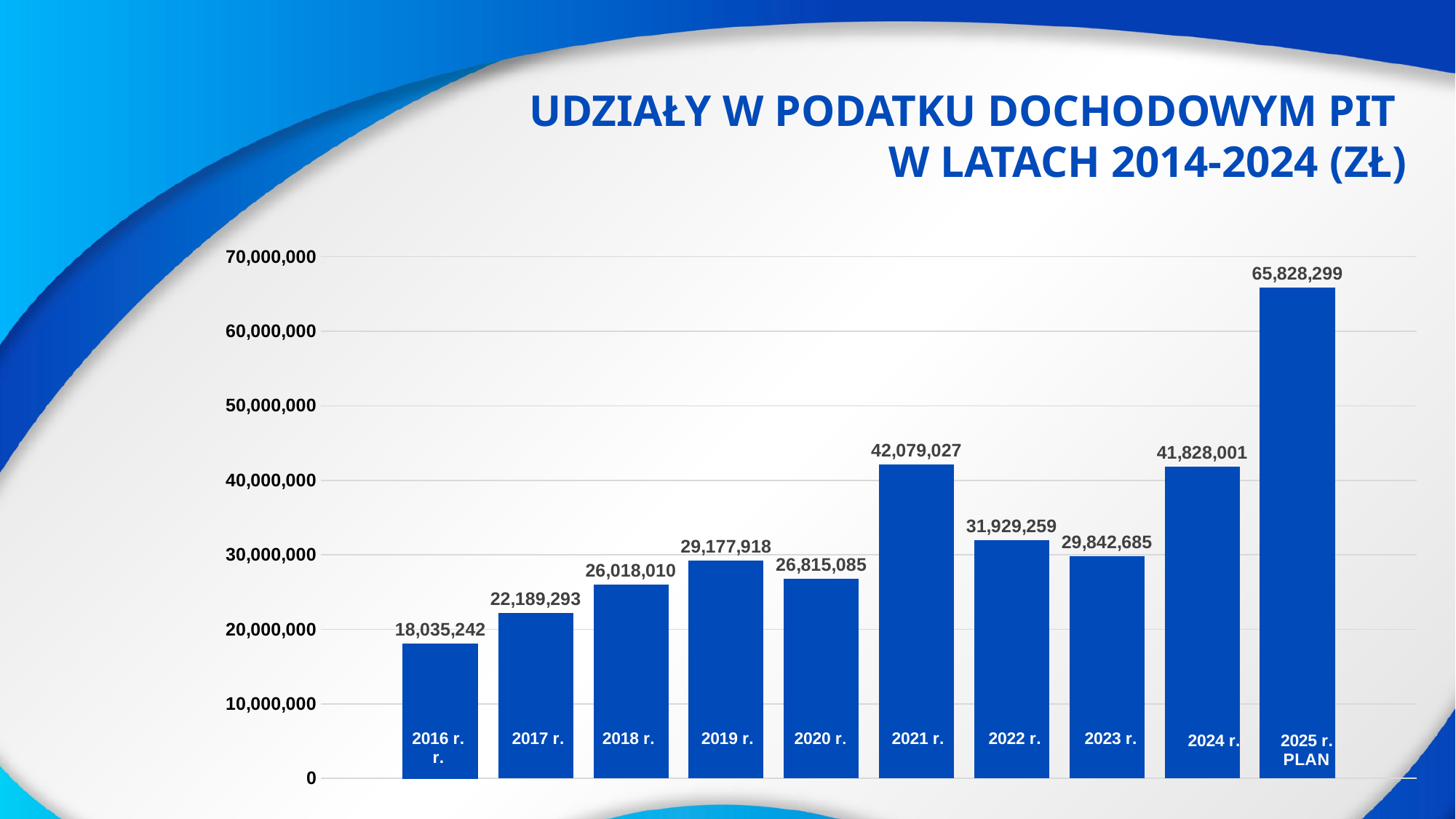
Which is larger, the value for 2022 r. or 2023 r.? 2022 r. What is the title of the chart? UDZIAŁY W PODATKU DOCHODOWYM PIT W LATACH 2014-2024 (ZŁ) How many bars are shown in the chart? 10 What is the difference between the values for 2021 r. and 2020 r.? 15,263,942 Which year has the highest value? 2025 r. PLAN What is the value for 2016 r.? 18,035,242 What is the difference between the values for 2025 r. PLAN and 2024 r.? 24,000,298 What is the value for 2025 r. PLAN? 65,828,299 Is the value for 2019 r. greater or less than 30,000,000? less Which year has the lowest value? 2016 r. What kind of chart is shown on the slide? bar chart What is the value for 2021 r.? 42,079,027